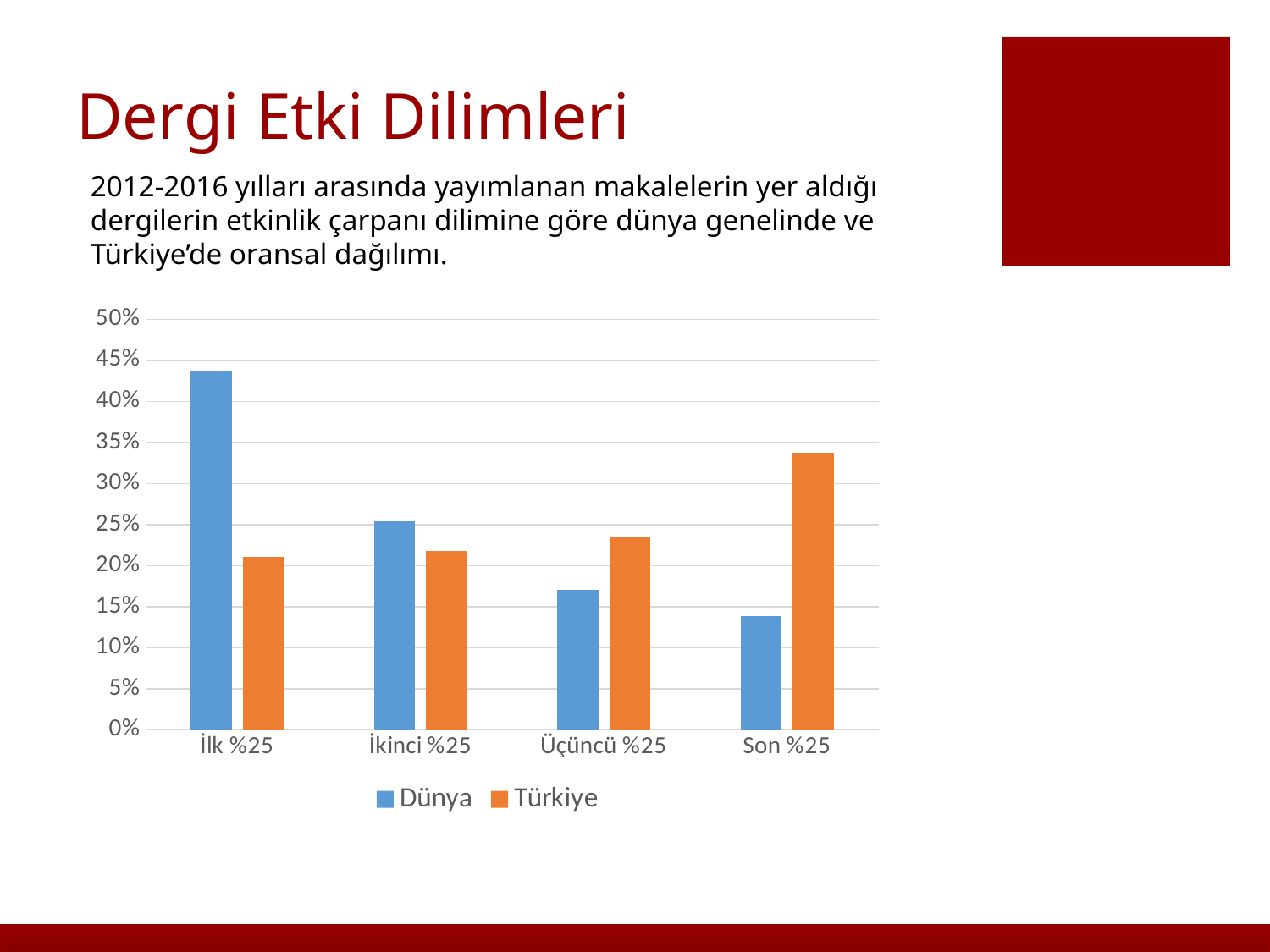
Is the Türkiye value for Son %25 greater or less than 30%? greater Which category has the highest value for the Dünya series? İlk %25 What kind of chart is shown on the slide? Bar chart For İlk %25, which series has the larger value, Dünya or Türkiye? Dünya Which category has the highest value for the Türkiye series? Son %25 How many series does the legend list? 2 Is the Dünya value for İlk %25 greater or less than 40%? greater Is the Dünya value for Üçüncü %25 greater or less than 20%? less Which category has the lowest value for the Dünya series? Son %25 Do the Dünya values rise or fall from İlk %25 to Son %25? fall How many categories are shown on the x axis? 4 For Son %25, which series has the larger value, Dünya or Türkiye? Türkiye